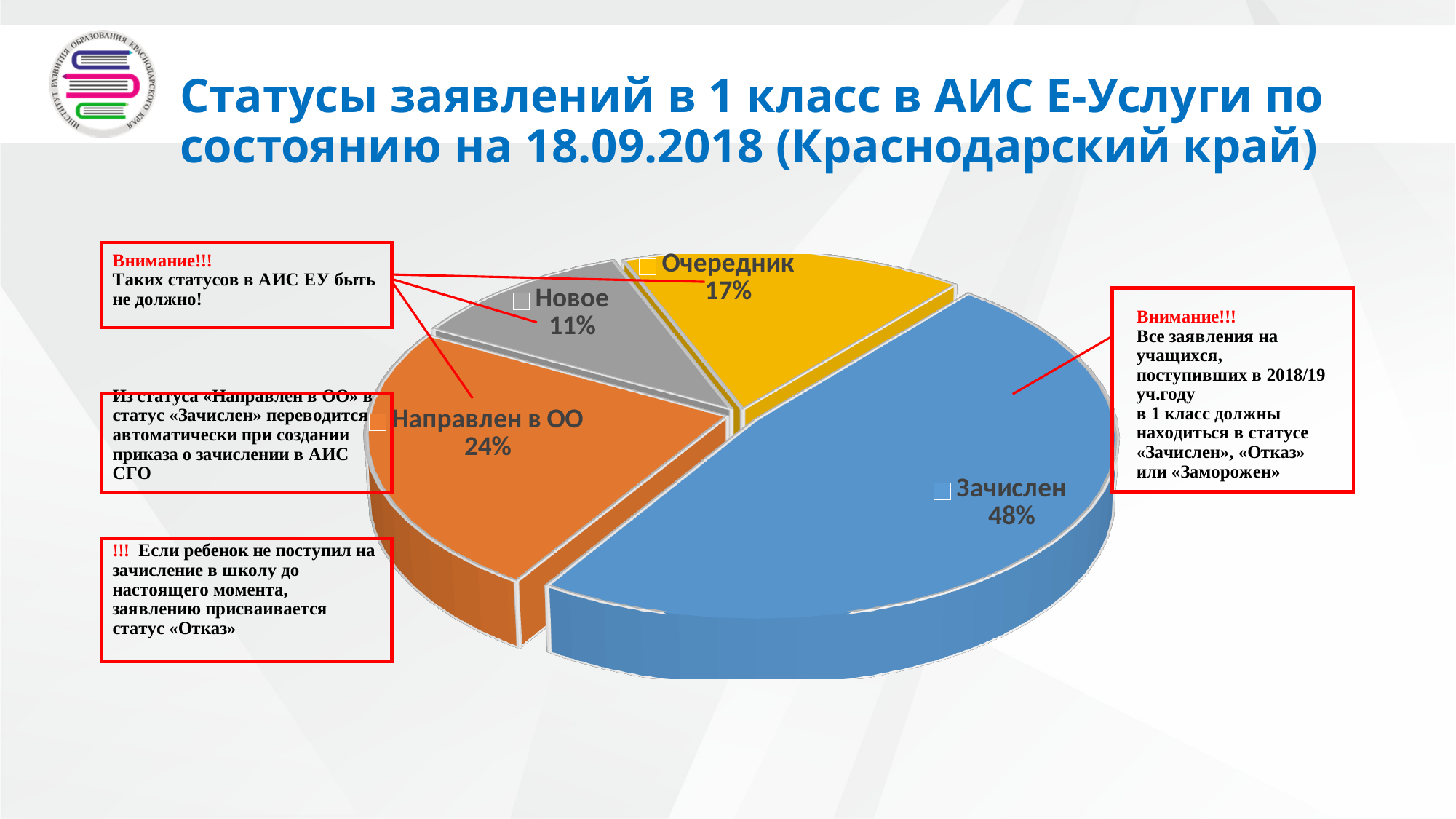
Which status has the largest share of the pie? Зачислен What share of applications has the status «Направлен в ОО»? 24% Which is larger, the share for «Очередник» or the share for «Новое»? Очередник What share of applications has the status «Новое»? 11% How many slices does the pie chart have? 4 What is the difference in percentage points between «Зачислен» and «Направлен в ОО»? 24 What share of applications has the status «Очередник»? 17% What kind of chart is shown on the slide? Pie chart What is the combined share of «Очередник» and «Новое»? 28% What share of applications has the status «Зачислен»? 48% What colour is the «Зачислен» slice of the pie? Blue Which status has the smallest share of the pie? Новое